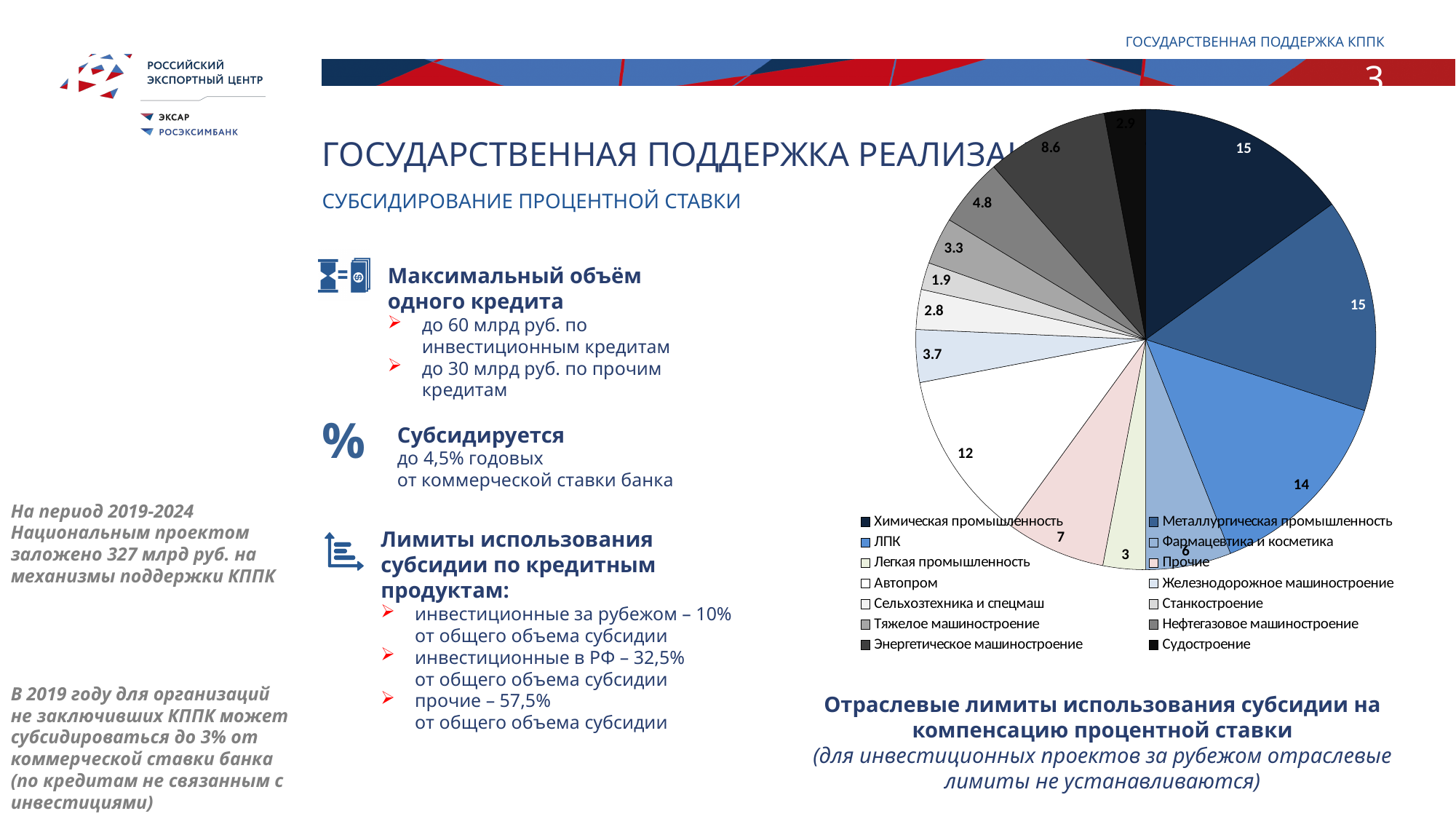
What is the difference between the values for ЛПК and Автопром? 2 What is the value for Энергетическое машиностроение in the pie chart? 8.6 What is the value for Автопром in the pie chart? 12 What is the value for Прочие in the pie chart? 7 Which category has the smallest slice in the pie chart? Станкостроение What kind of chart is shown on the slide? pie chart What is the difference between the values for Энергетическое машиностроение and Нефтегазовое машиностроение? 3.8 What is the title printed below the pie chart (bold text)? Отраслевые лимиты использования субсидии на компенсацию процентной ставки What is the value for Судостроение in the pie chart? 2.9 Which is larger, the value for Нефтегазовое машиностроение or for Тяжелое машиностроение? Нефтегазовое машиностроение How many slices does the pie chart have? 14 What is the value for ЛПК in the pie chart? 14